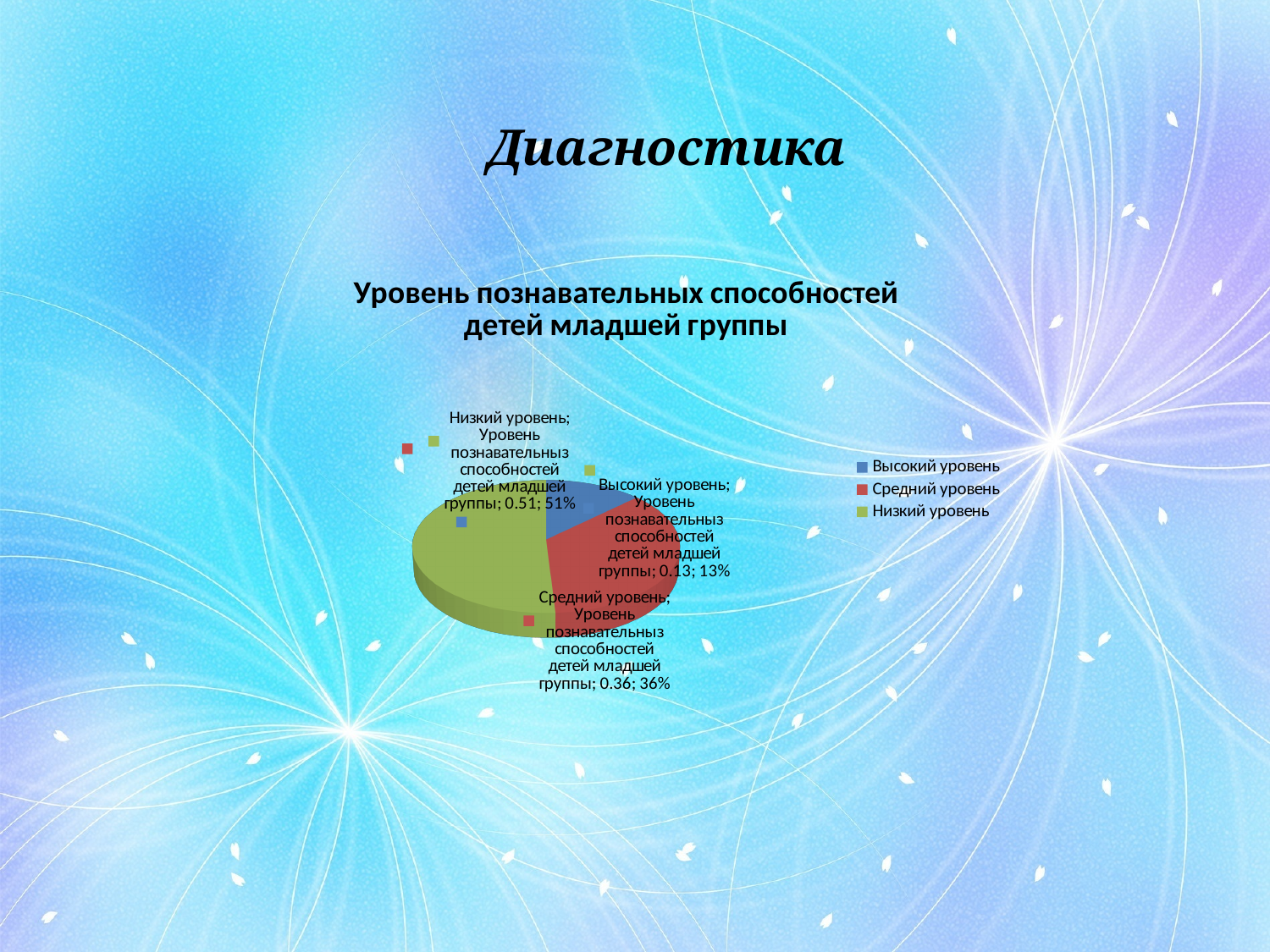
What percentage share does the slice for Высокий уровень have? 13% What is the difference in percentage points between the Низкий уровень and Средний уровень slices? 15% How many slices does the pie chart have? 3 What percentage share does the slice for Низкий уровень have? 51% Which level has the smallest slice of the pie? Высокий уровень What is the title of the chart? Уровень познавательных способностей детей младшей группы What value is printed for Средний уровень in the data label? 0.36 Which slice is larger, Средний уровень or Высокий уровень? Средний уровень How many entries does the legend list? 3 What kind of chart is shown on the slide? Pie chart Which level has the largest slice of the pie? Низкий уровень What percentage share does the slice for Средний уровень have? 36%